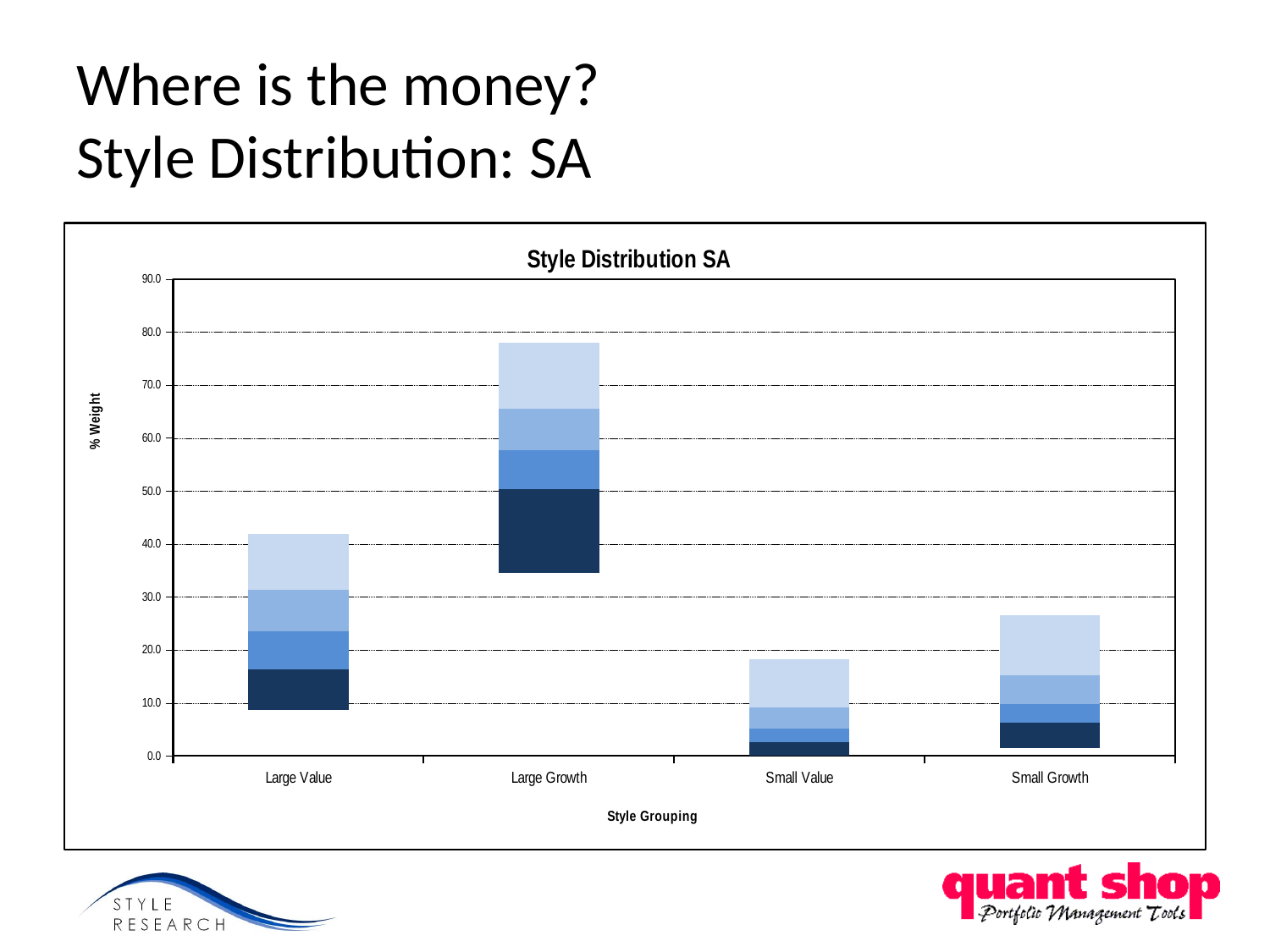
What is the title of the chart? Style Distribution SA Which style grouping has the lowest top of its bar? Small Value Which style grouping has the highest top of its bar? Large Growth How many style groupings are shown on the x axis of the chart? 4 Is the top of the bar for Large Growth greater or less than 70.0? greater Is the top of the bar for Small Growth greater or less than 20.0? greater Is the top of the bar for Small Value greater or less than 20.0? less What kind of chart is shown on the slide? Stacked bar chart What is the label on the vertical axis of the chart? % Weight Which bar reaches higher, Large Value or Small Growth? Large Value